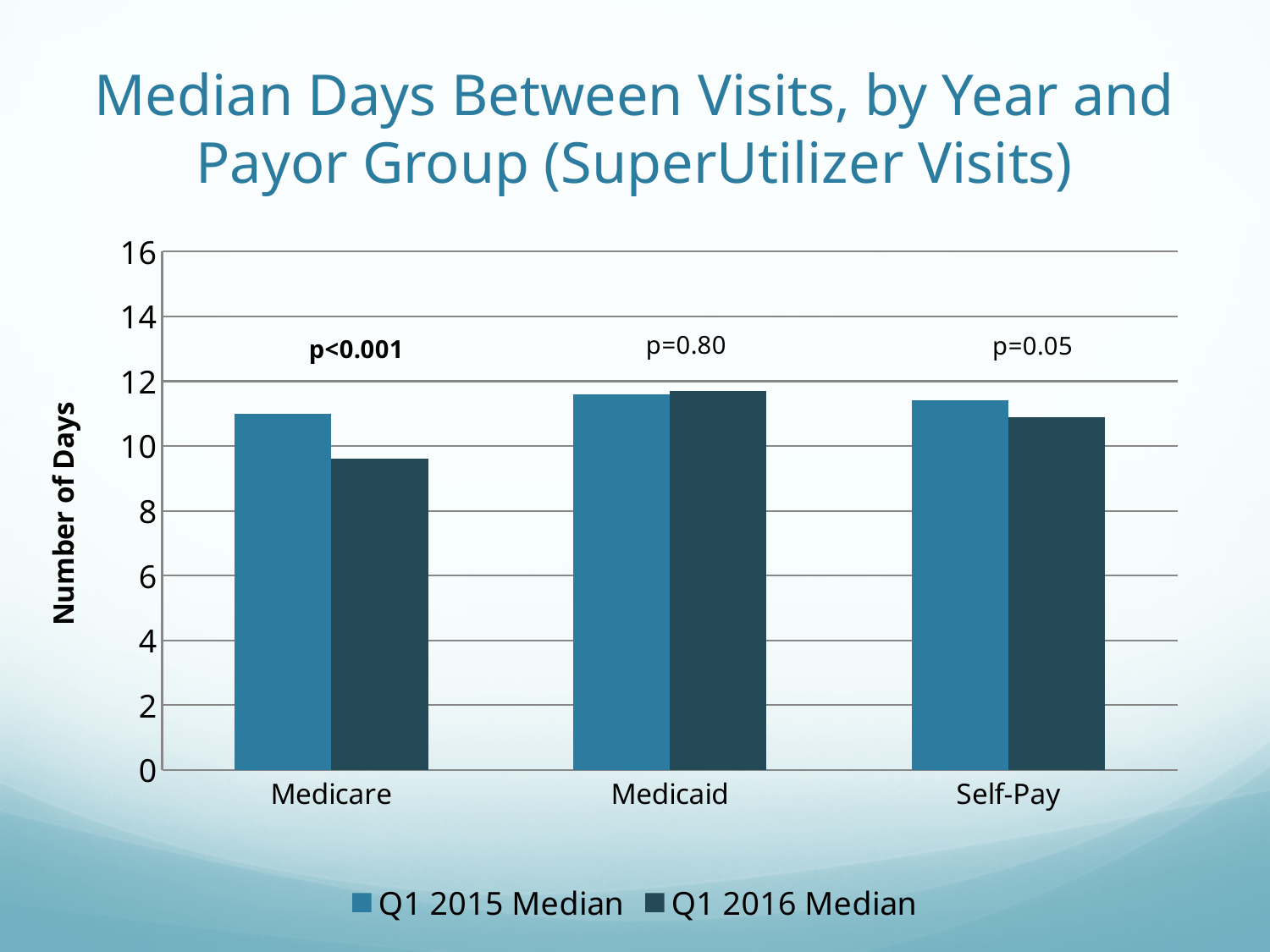
Is the Q1 2015 Median value for Medicare greater or less than 10? greater Is the Q1 2015 Median value for Medicaid greater or less than 12? less For Self-Pay, which is larger: the Q1 2015 Median or the Q1 2016 Median? Q1 2015 Median What p-value is printed above the Medicare bars? p<0.001 For Medicare, which is larger: the Q1 2015 Median or the Q1 2016 Median? Q1 2015 Median Which payor group has the lowest Q1 2016 Median value? Medicare What is the title of the y axis? Number of Days Is the Q1 2016 Median value for Medicare greater or less than 10? less What kind of chart is shown on the slide? bar chart How many payor groups are shown on the x axis? 3 How many series does the legend list? 2